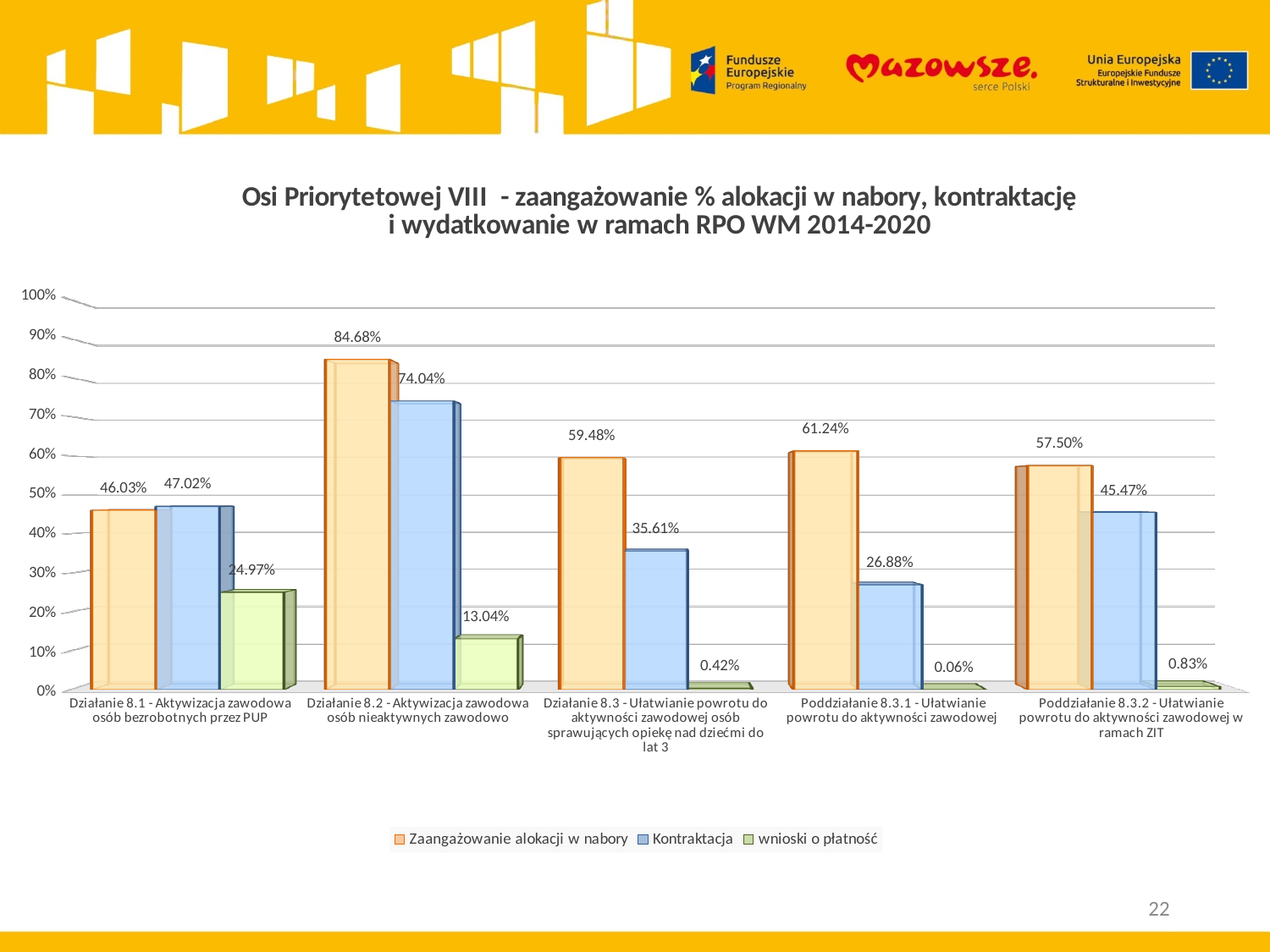
What kind of chart is shown on the slide? Bar chart For Działanie 8.1 - Aktywizacja zawodowa osób bezrobotnych przez PUP, which is larger: "Zaangażowanie alokacji w nabory" or "Kontraktacja"? Kontraktacja What is the "wnioski o płatność" value for Działanie 8.1 - Aktywizacja zawodowa osób bezrobotnych przez PUP? 24.97% What is the "Kontraktacja" value for Poddziałanie 8.3.2 - Ułatwianie powrotu do aktywności zawodowej w ramach ZIT? 45.47% What is the difference between the "Zaangażowanie alokacji w nabory" and "Kontraktacja" values for Działanie 8.3 - Ułatwianie powrotu do aktywności zawodowej osób sprawujących opiekę nad dziećmi do lat 3? 23.87% Which category has the lowest "wnioski o płatność" value? Poddziałanie 8.3.1 - Ułatwianie powrotu do aktywności zawodowej What is the value of "Zaangażowanie alokacji w nabory" for Działanie 8.2 - Aktywizacja zawodowa osób nieaktywnych zawodowo? 84.68% How many categories are shown on the x axis of the chart? 5 Which category has the highest "Zaangażowanie alokacji w nabory" value? Działanie 8.2 - Aktywizacja zawodowa osób nieaktywnych zawodowo How many series does the legend list? 3 Which series is shown in green in the legend? wnioski o płatność Is the "Kontraktacja" value for Poddziałanie 8.3.1 - Ułatwianie powrotu do aktywności zawodowej greater or less than 30%? less